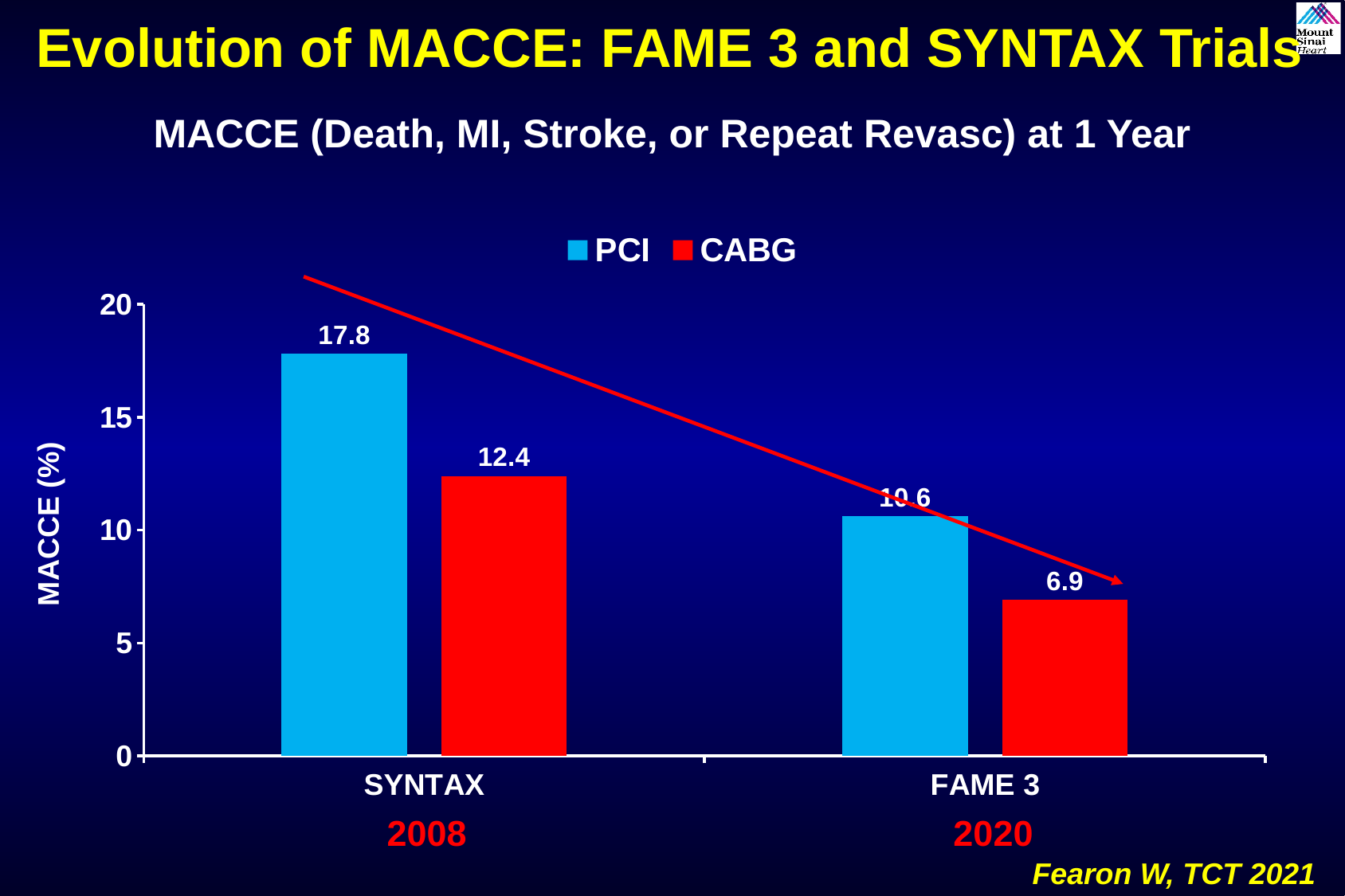
What is the MACCE rate for PCI in the FAME 3 trial? 10.6 What is the MACCE rate for CABG in the SYNTAX trial? 12.4 What is the MACCE rate for PCI in the SYNTAX trial? 17.8 What kind of chart is shown on the slide? Bar chart Which is larger, the CABG MACCE rate in SYNTAX or the PCI MACCE rate in FAME 3? CABG in SYNTAX What is the difference between the PCI and CABG MACCE rates in the SYNTAX trial? 5.4 What is the difference between the PCI MACCE rate in SYNTAX and the PCI MACCE rate in FAME 3? 7.2 Which bar has the lowest MACCE rate on the chart? CABG in FAME 3 Which bar has the highest MACCE rate on the chart? PCI in SYNTAX How many series does the legend list? 2 How many trials (categories) are shown on the x axis? 2 What is the MACCE rate for CABG in the FAME 3 trial? 6.9